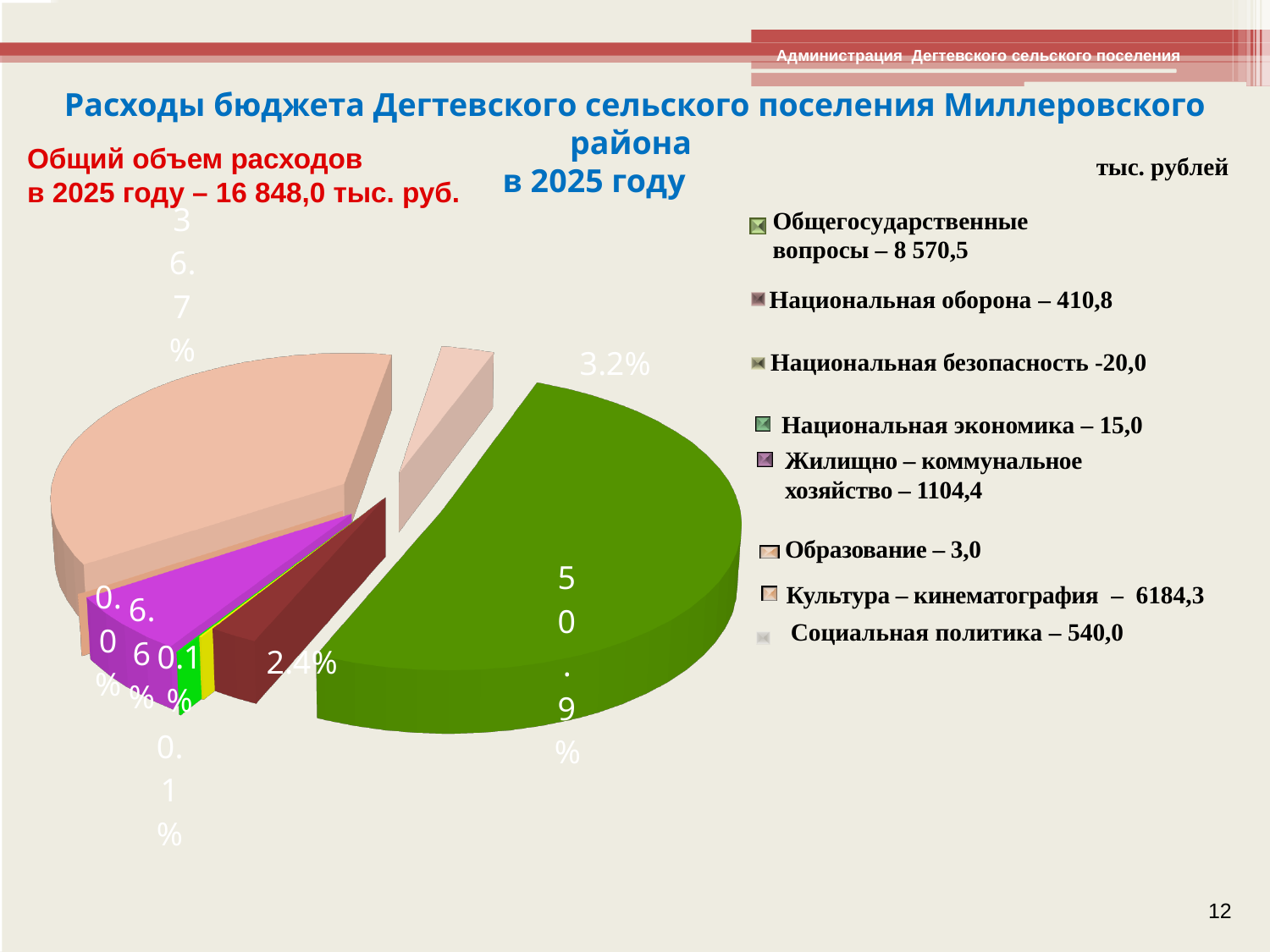
What is the value for Национальная оборона? 410,8 How many expenditure categories does the legend list? 8 What share of the pie does the largest slice (Общегосударственные вопросы) represent? 50.9% Which is larger: Национальная безопасность or Национальная экономика? Национальная безопасность What is the total volume of expenditures in 2025 stated on the slide? 16 848,0 тыс. руб. What is the value for Жилищно – коммунальное хозяйство? 1104,4 What is the value for Социальная политика? 540,0 What is the value for Культура – кинематография? 6184,3 Which expenditure category has the largest value? Общегосударственные вопросы Which expenditure category has the smallest value? Образование What is the difference between the values for Общегосударственные вопросы and Культура – кинематография? 2386,2 What kind of chart is shown on the slide? pie chart